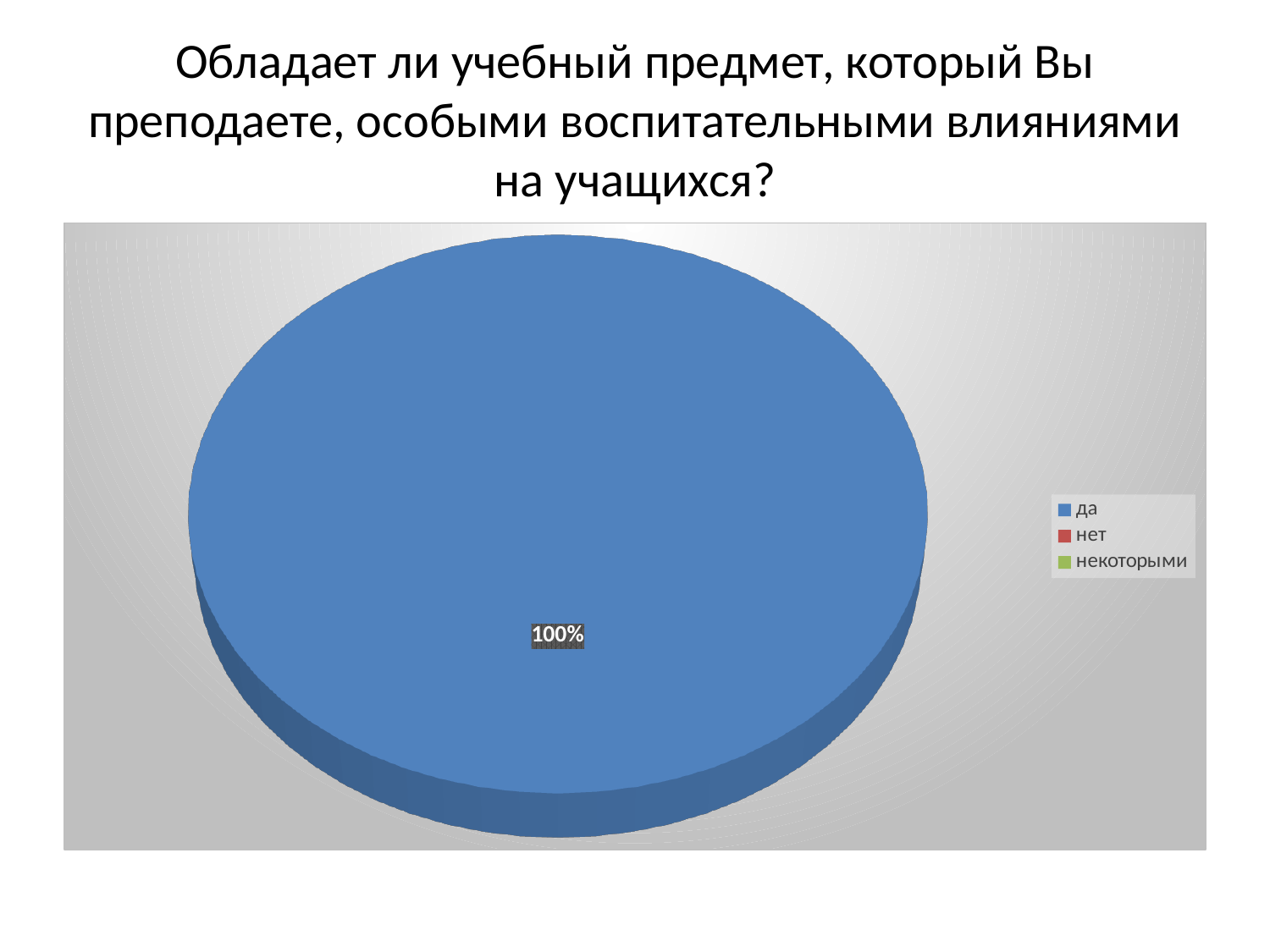
What share of the pie does the "да" slice take? 100% How many entries does the legend list? 3 Which legend entry is listed last? некоторыми What colour is the "да" slice in the pie chart? blue What kind of chart is shown on the slide? pie chart Is the share for "да" greater or less than 50%? greater Which category has the largest share of the pie? да What is the only percentage label printed on the pie chart? 100%